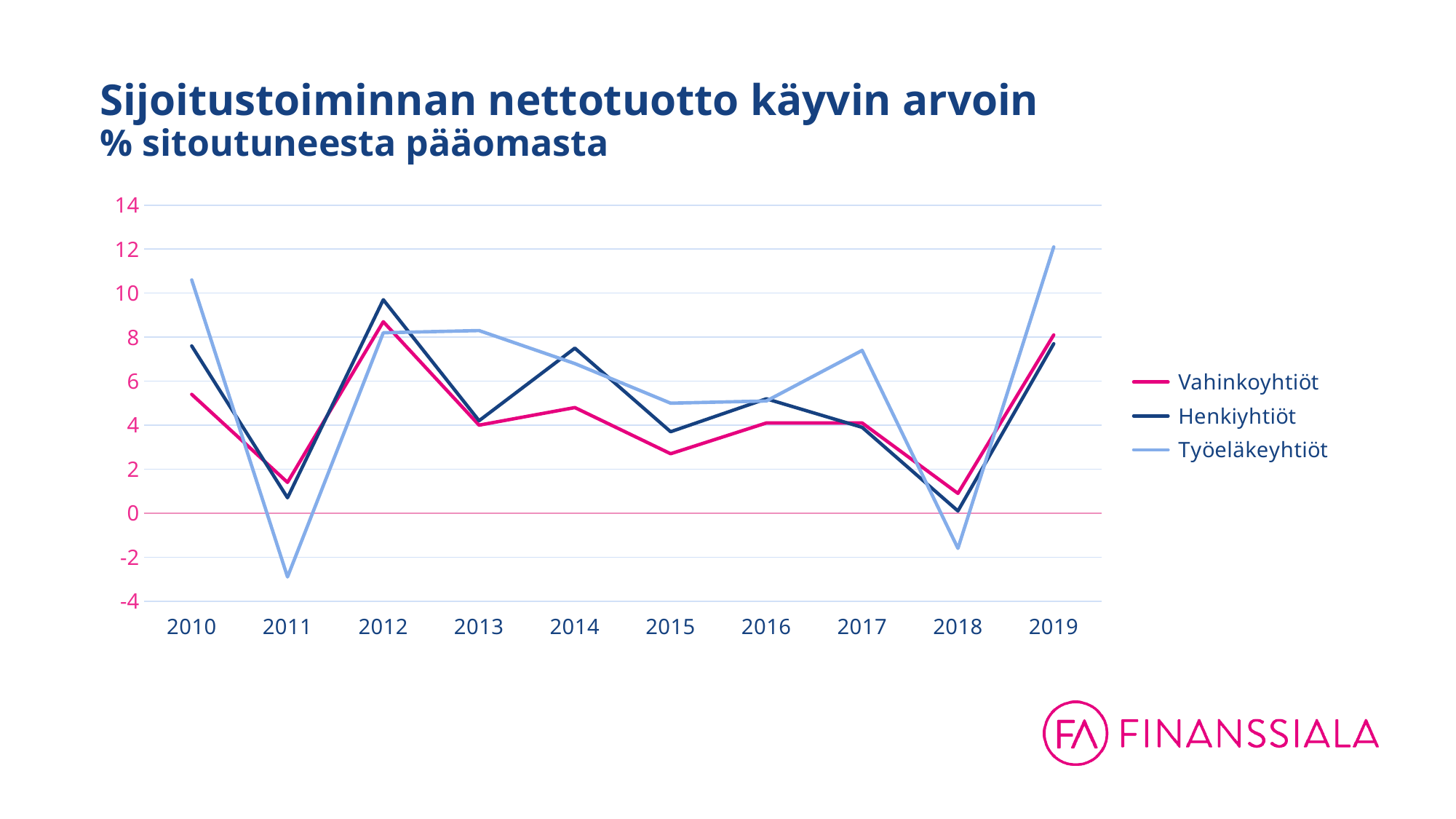
In which year is the value for Henkiyhtiöt highest? 2012 Is the value for Työeläkeyhtiöt in 2018 greater or less than 0? less In 2014, which is larger: Henkiyhtiöt or Vahinkoyhtiöt? Henkiyhtiöt How many series does the legend list? 3 In which year is the value for Työeläkeyhtiöt lowest? 2011 Does the value for Vahinkoyhtiöt rise or fall from 2017 to 2018? fall Is the value for Henkiyhtiöt in 2012 greater or less than 8? greater In which year is the value for Työeläkeyhtiöt highest? 2019 What kind of chart is shown on the slide? Line chart How many years are shown on the x axis? 10 In 2010, which is larger: Työeläkeyhtiöt or Vahinkoyhtiöt? Työeläkeyhtiöt Is the value for Työeläkeyhtiöt in 2010 greater or less than 10? greater